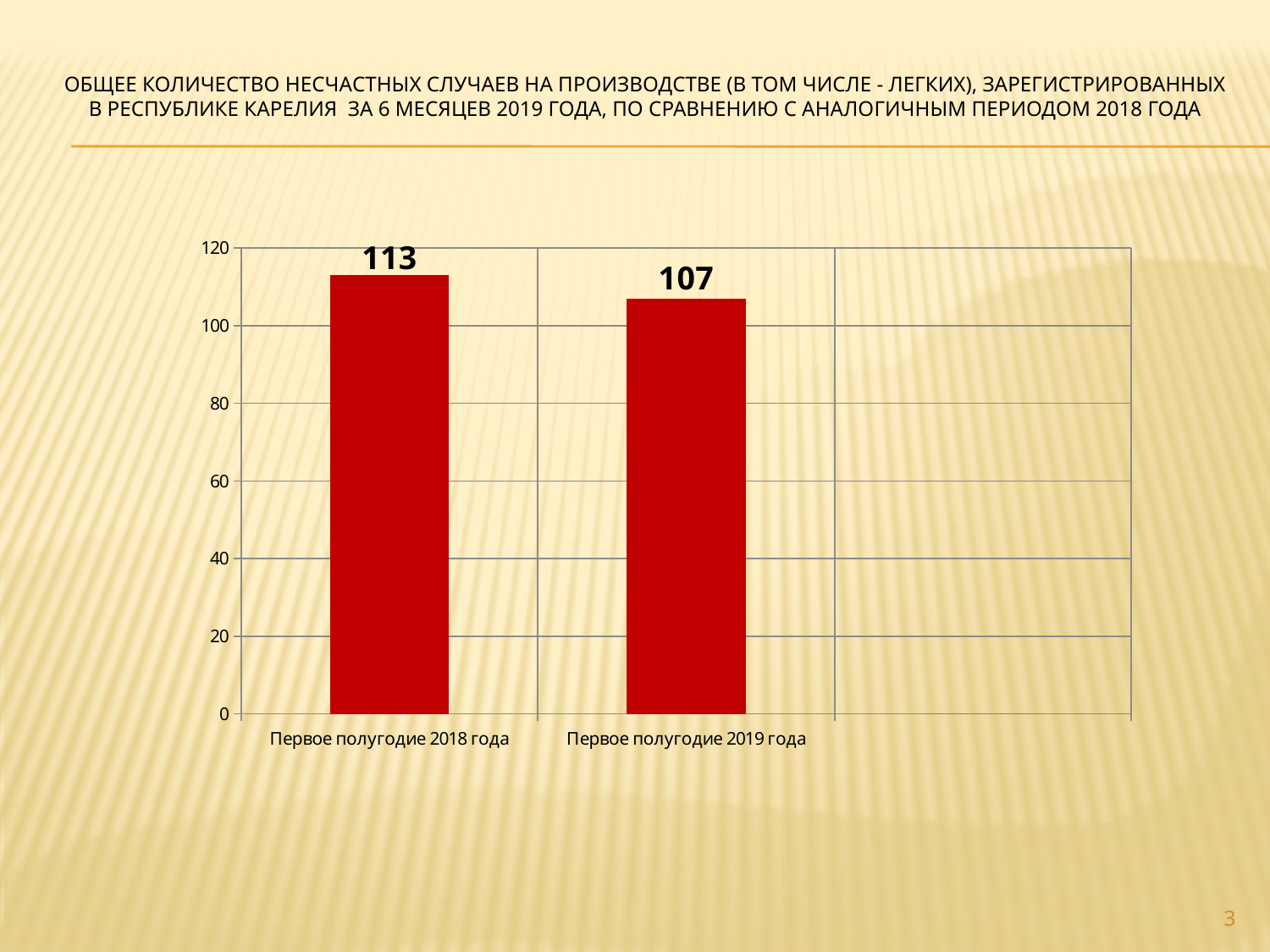
Which category has the lowest value? Первое полугодие 2019 года How many categories are shown on the chart? 2 What is the value for Первое полугодие 2018 года? 113 What kind of chart is shown on the slide? bar chart Do the values rise or fall from Первое полугодие 2018 года to Первое полугодие 2019 года? fall Which category has the highest value? Первое полугодие 2018 года Is the value for Первое полугодие 2019 года greater or less than 100? greater Which is larger: the value for Первое полугодие 2018 года or for Первое полугодие 2019 года? Первое полугодие 2018 года Is the value for Первое полугодие 2018 года greater or less than 120? less What is the value for Первое полугодие 2019 года? 107 What colour are the bars on the chart? red What is the difference between the values for Первое полугодие 2018 года and Первое полугодие 2019 года? 6